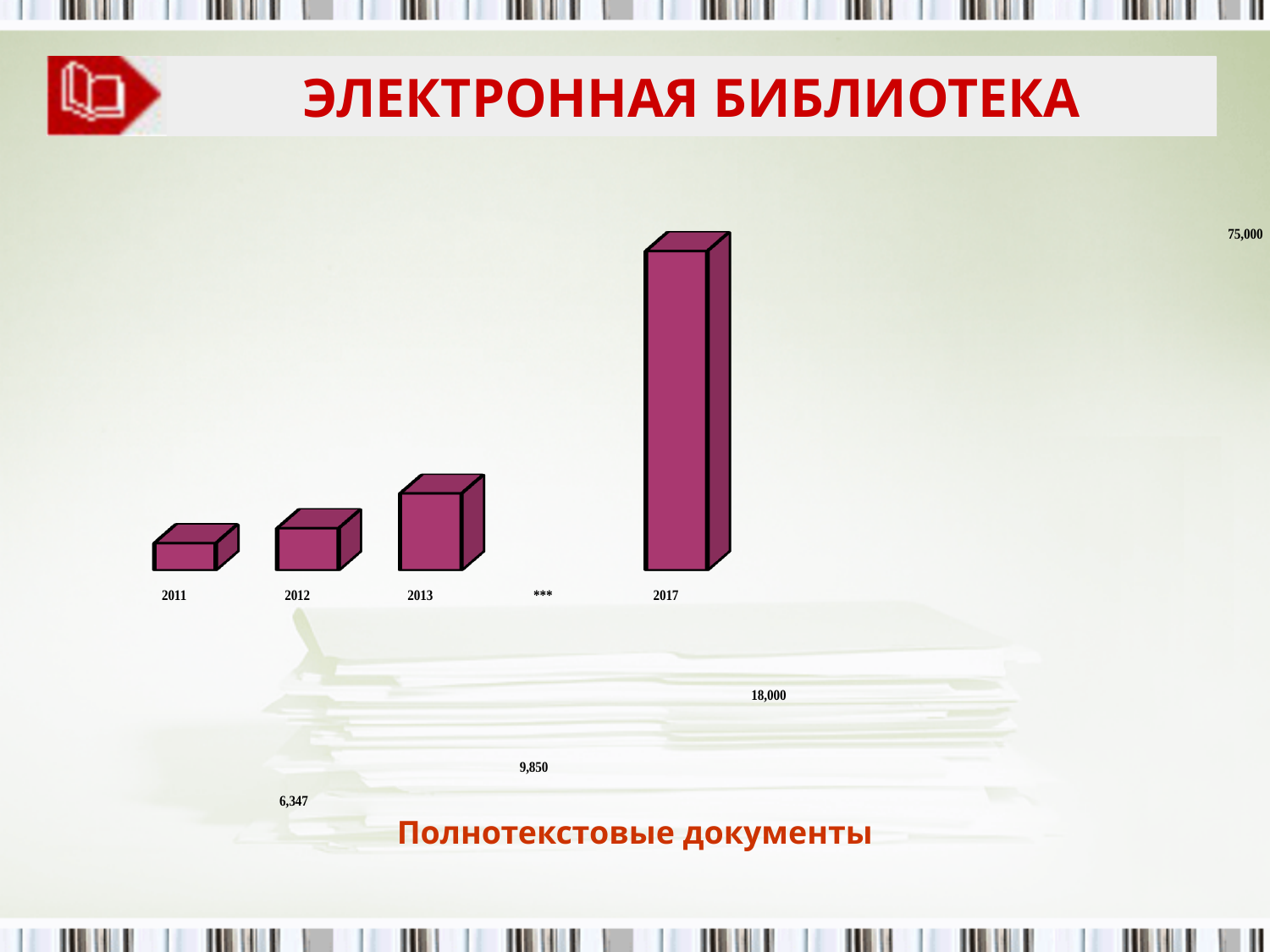
Which year has the tallest bar in the chart? 2017 What is the smallest data label value shown on the chart? 6,347 Which year has the shortest bar in the chart? 2011 Do the bar heights rise or fall from 2011 to 2017? rise What colour are the bars in the chart? magenta (purple-pink) What is the largest data label value shown on the chart? 75,000 How many bars are plotted in the chart? 4 Is the bar for 2012 taller or shorter than the bar for 2011? taller What is the title printed below the chart? Полнотекстовые документы What kind of chart is shown on the slide? bar chart Is the bar for 2017 taller or shorter than the bar for 2013? taller What is the difference between the largest data label (75,000) and the smallest data label (6,347) on the chart? 68,653